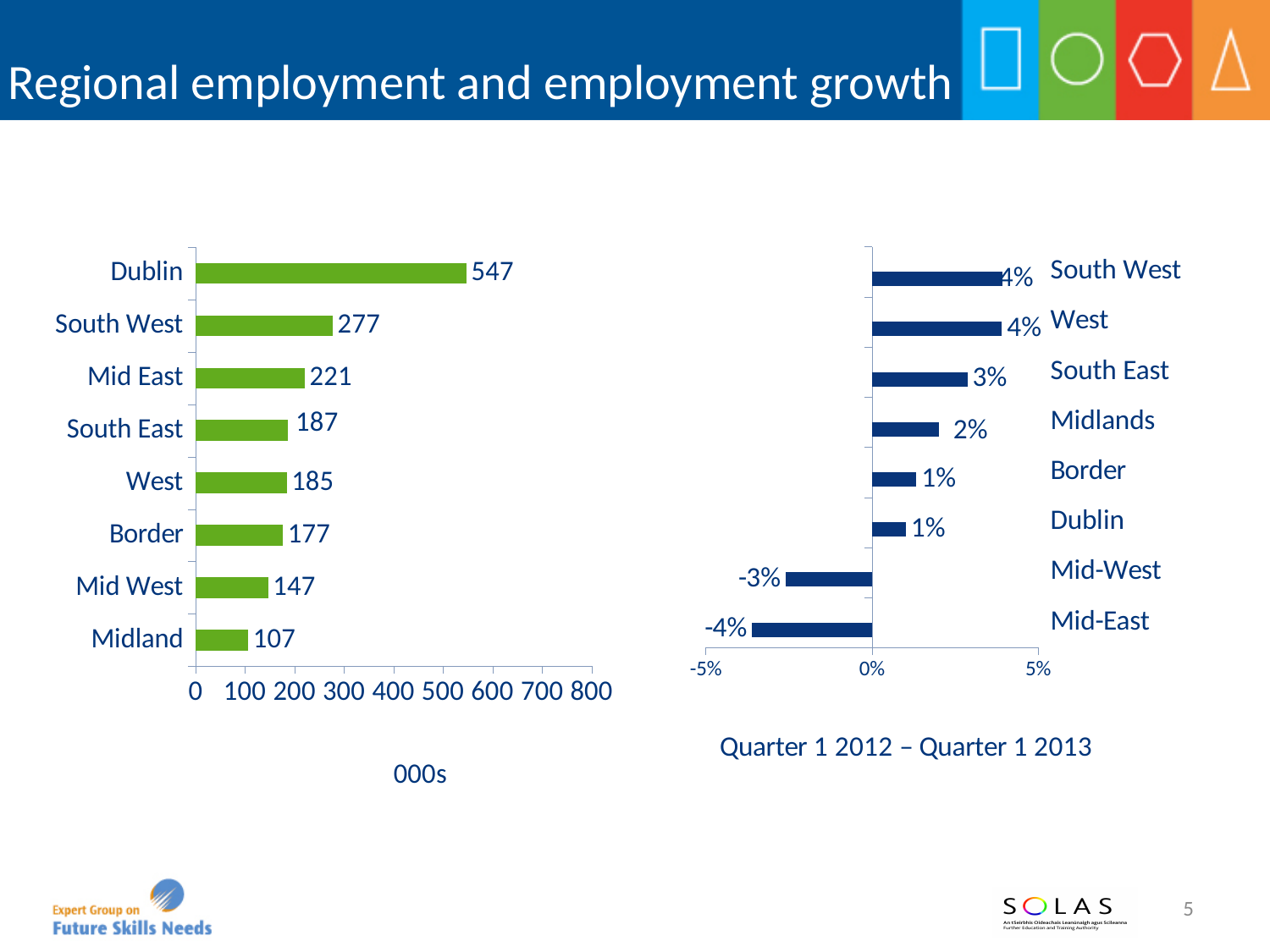
On the left chart (employment in 000s), which region has the lowest value? Midland On the right chart (Quarter 1 2012 – Quarter 1 2013), what is the value for Mid-East? -4% On the right chart (Quarter 1 2012 – Quarter 1 2013), which region has the lowest value? Mid-East On the left chart (employment in 000s), how many regions are shown? 8 On the left chart (employment in 000s), what is the difference between Dublin and South West? 270 What is the title of the slide? Regional employment and employment growth On the left chart (employment in 000s), what is the value for Dublin? 547 What kind of chart is the left chart (employment in 000s)? bar chart On the left chart (employment in 000s), is the value for Border greater or less than 200? less On the right chart (Quarter 1 2012 – Quarter 1 2013), what is the value for South East? 3% On the right chart (Quarter 1 2012 – Quarter 1 2013), which is larger, Midlands or Border? Midlands On the left chart (employment in 000s), what is the value for Mid West? 147